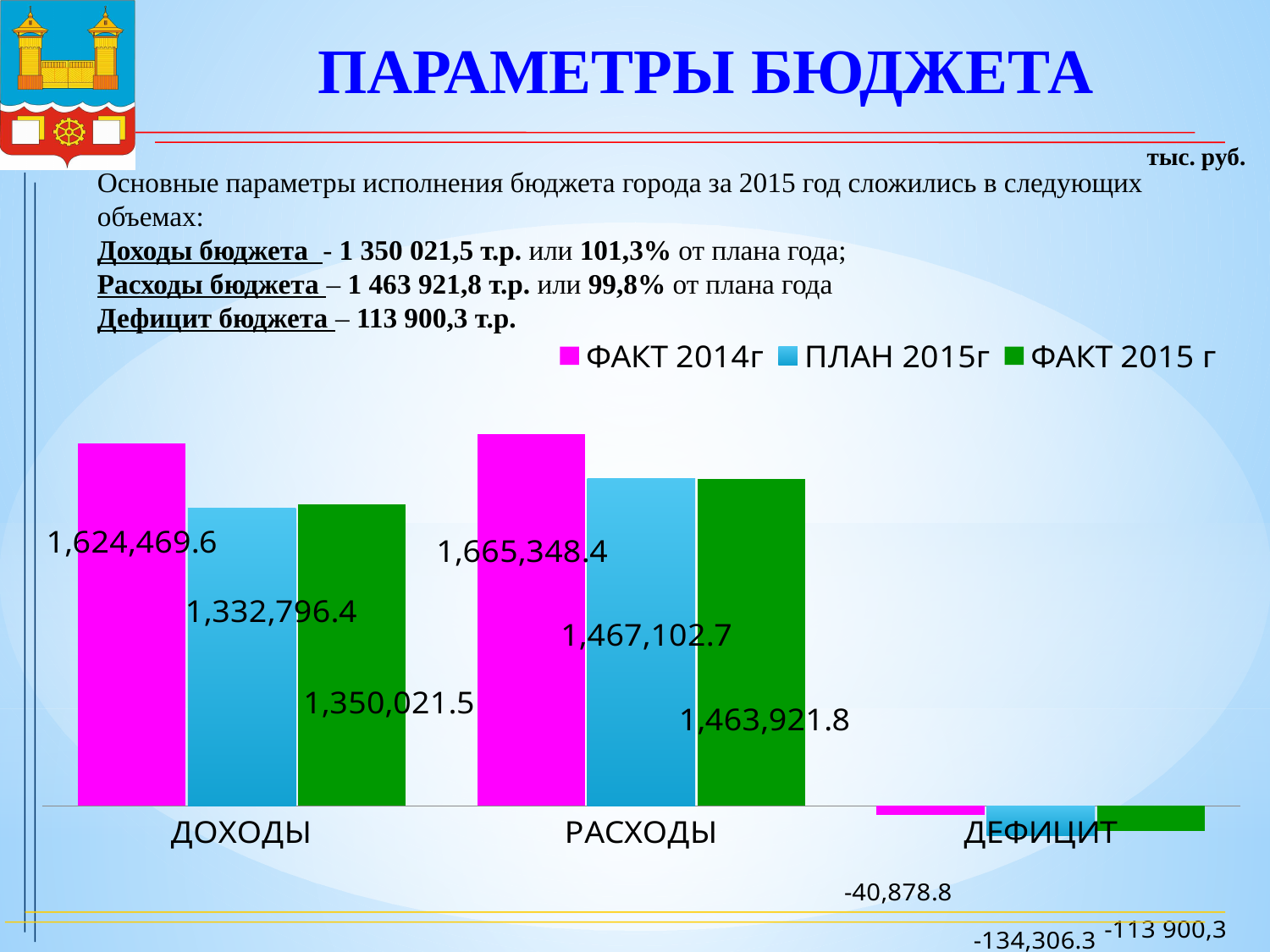
What is the ПЛАН 2015г value for ДЕФИЦИТ? -134,306.3 What type of chart is shown on the slide? bar chart Which is larger for ДОХОДЫ: the ФАКТ 2014г value or the ФАКТ 2015 г value? ФАКТ 2014г What is the ФАКТ 2014г value for ДЕФИЦИТ? -40,878.8 What is the ПЛАН 2015г value for ДОХОДЫ? 1,332,796.4 What is the ФАКТ 2014г value for ДОХОДЫ? 1,624,469.6 Which category has the lowest ФАКТ 2015 г value? ДЕФИЦИТ How many series does the chart legend list? 3 Which category has the highest ФАКТ 2014г value? РАСХОДЫ What is the difference between the ФАКТ 2014г values for РАСХОДЫ and ДОХОДЫ? 40,878.8 What is the ФАКТ 2015 г value for РАСХОДЫ? 1,463,921.8 How many categories are shown on the x axis of the chart? 3